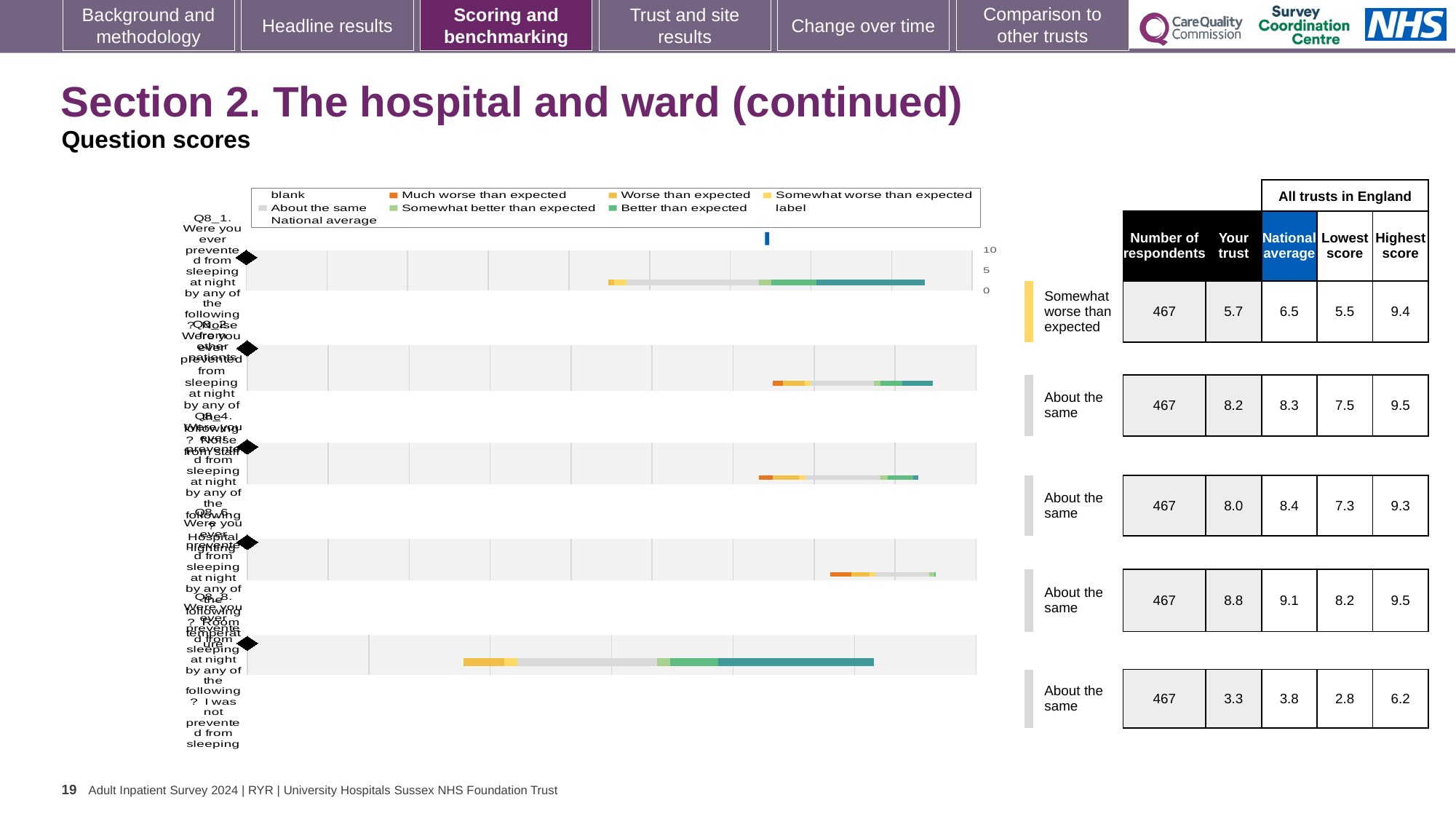
What benchmark category is given for the first row? Somewhat worse than expected What is the national average for the first row of the table? 6.5 What is the highest 'Your trust' score shown in the table? 8.8 What is the maximum value shown on the chart's score axis? 10 What is the highest score across all trusts in England for the last row of the table? 6.2 In the first row, which is larger: the 'Your trust' score or the national average? National average What is the 'Your trust' score for the first row of the table? 5.7 What is the number of respondents shown for the first row of the table? 467 What is the lowest 'Your trust' score shown in the table? 3.3 What is the difference between the national average and the 'Your trust' score in the first row? 0.8 How many question rows (bars) does the chart show? 5 What kind of chart is shown on the slide? bar chart